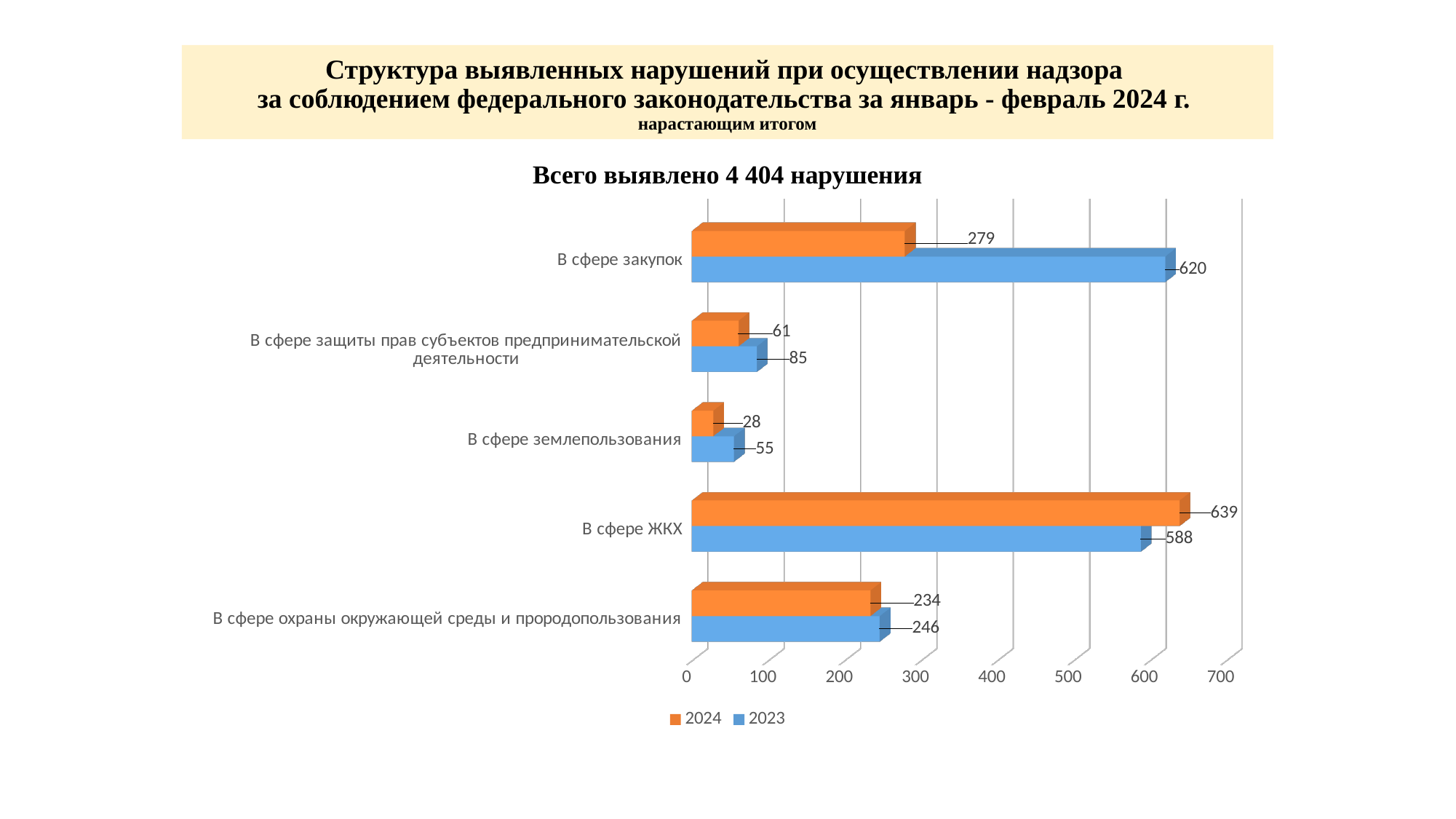
What is the 2023 value for «В сфере защиты прав субъектов предпринимательской деятельности»? 85 How many series does the legend list? 2 For «В сфере охраны окружающей среды и пророодопользования», which series has the larger value, 2024 or 2023? 2023 How many categories are shown on the chart? 5 What is the 2024 value for «В сфере закупок»? 279 What is the 2023 value for «В сфере ЖКХ»? 588 What kind of chart is shown on the slide? Bar chart Which category has the lowest 2023 value? В сфере землепользования What is the 2024 value for «В сфере землепользования»? 28 What is the difference between the 2023 and 2024 values for «В сфере закупок»? 341 Which category has the highest 2024 value? В сфере ЖКХ What total number of violations is stated above the chart? 4 404